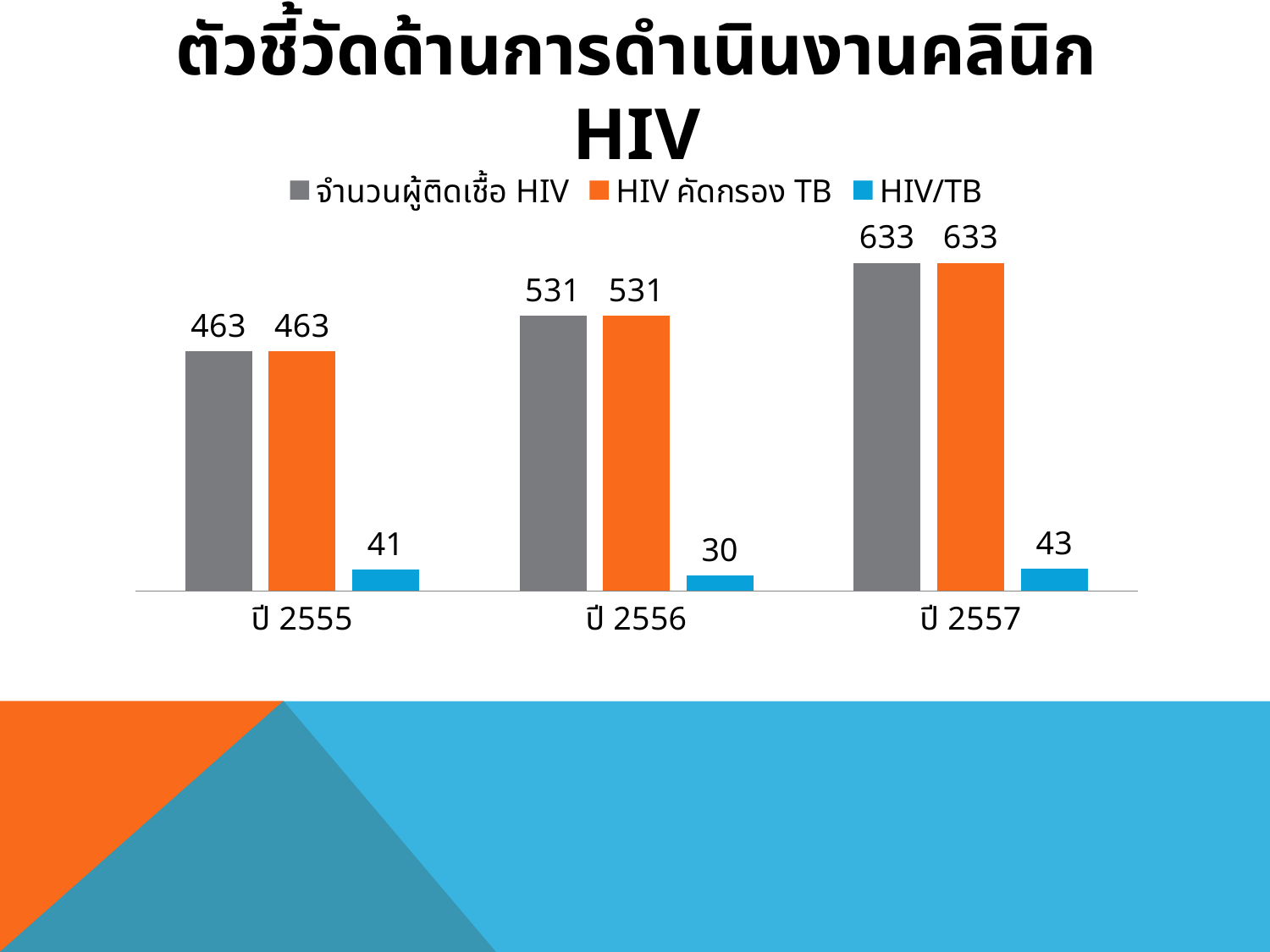
How many series does the legend list? 3 Which is larger: HIV/TB in ปี 2555 or HIV/TB in ปี 2557? ปี 2557 Which year has the lowest value for HIV/TB? ปี 2556 What is the value of HIV/TB for ปี 2557? 43 What kind of chart is shown on the slide? Bar chart What is the difference between จำนวนผู้ติดเชื้อ HIV in ปี 2557 and ปี 2555? 170 Does the value of จำนวนผู้ติดเชื้อ HIV rise or fall from ปี 2555 to ปี 2557? Rise How many years (categories) are shown on the x axis? 3 Which year has the highest value for จำนวนผู้ติดเชื้อ HIV? ปี 2557 What is the value of HIV/TB for ปี 2556? 30 What is the value of จำนวนผู้ติดเชื้อ HIV for ปี 2555? 463 What is the value of HIV คัดกรอง TB for ปี 2556? 531